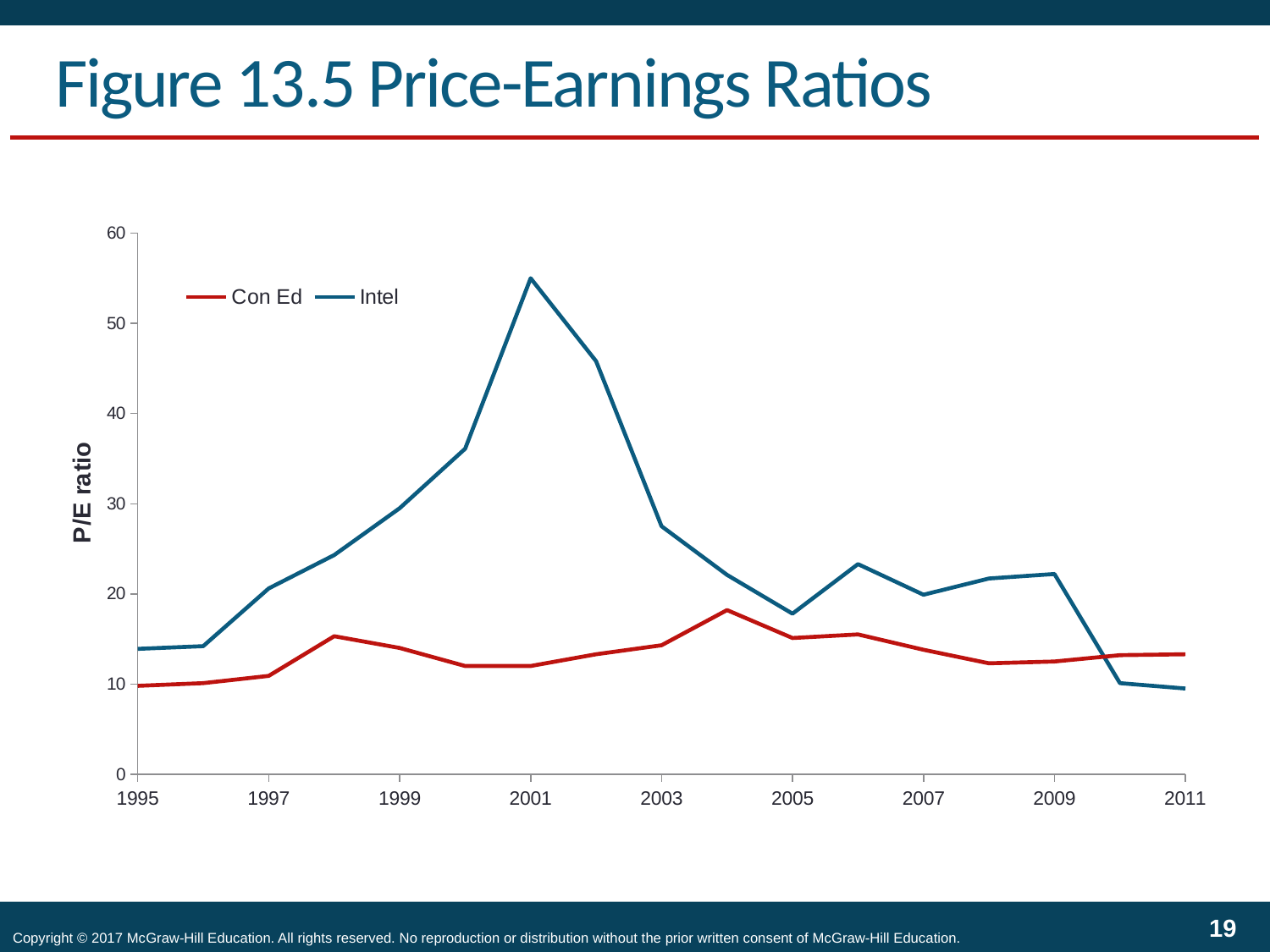
Is the value for Con Ed in 2001 greater or less than 20? less What are the two series named in the legend? Con Ed and Intel Which series has the higher value in 2011, Con Ed or Intel? Con Ed In which year does the Con Ed line reach its highest value? 2004 What kind of chart is shown on the slide? line chart In which year does the Intel line reach its highest value? 2001 What is the label on the vertical axis? P/E ratio How many series does the legend list? 2 Does the Intel line rise or fall between 1995 and 2001? rise Is the value for Intel in 2001 greater or less than 50? greater Is the value for Intel in 2005 greater or less than 20? less Which series has the higher value in 2001, Con Ed or Intel? Intel